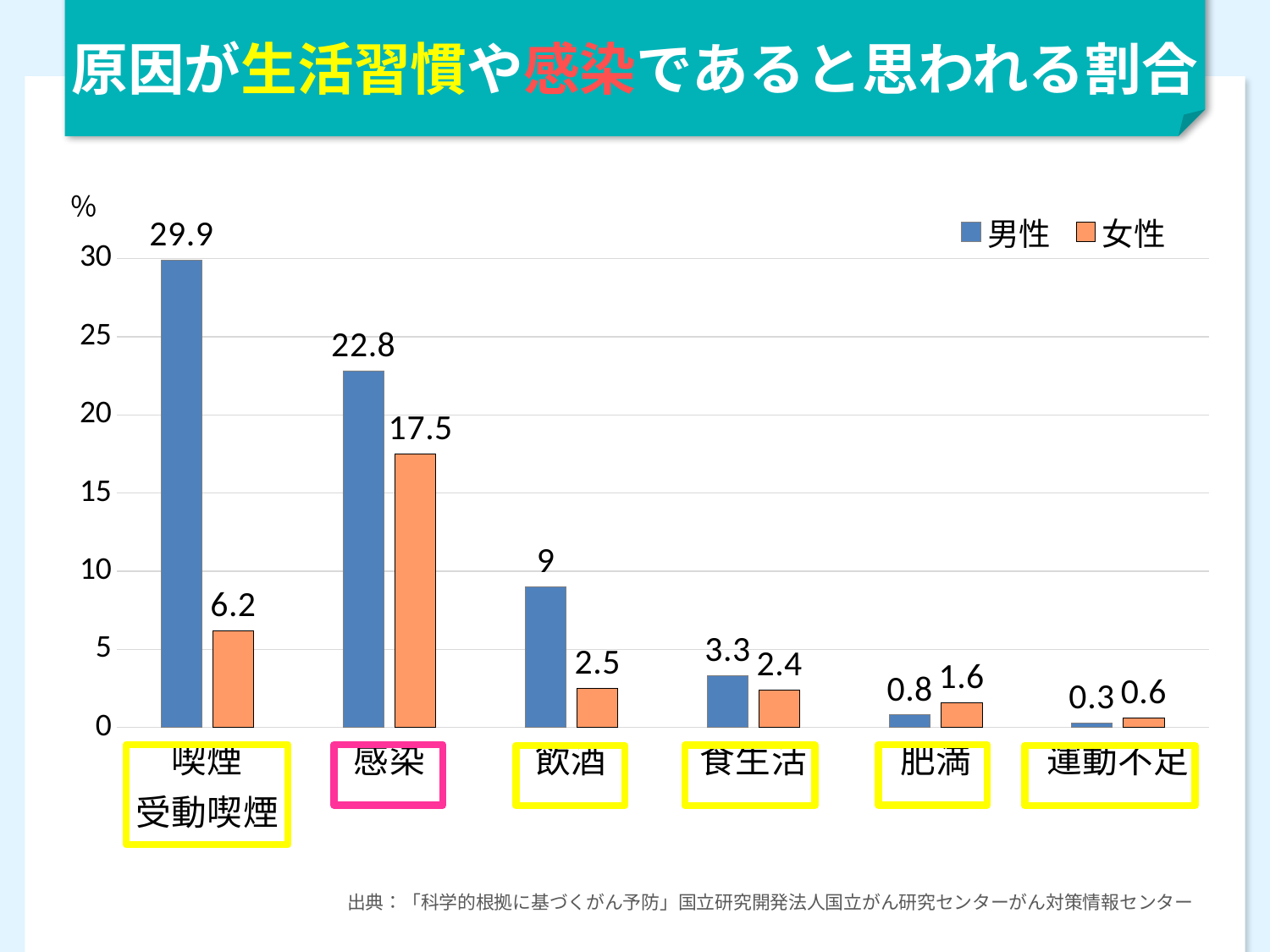
Which category has the highest value for 男性? 喫煙・受動喫煙 What is the difference between the 男性 and 女性 values in the 喫煙・受動喫煙 category? 23.7 How many categories are shown on the x axis? 6 Which category has the lowest value for 女性? 運動不足 Is the 男性 value for 感染 greater or less than 20? greater What kind of chart is shown on the slide? bar chart What is the value for 女性 in the 感染 category? 17.5 Which is larger in the 肥満 category, the 男性 value or the 女性 value? 女性 What is the value for 女性 in the 飲酒 category? 2.5 What is the difference between the 男性 and 女性 values in the 感染 category? 5.3 What is the value for 男性 in the 喫煙・受動喫煙 category? 29.9 How many series does the legend list? 2